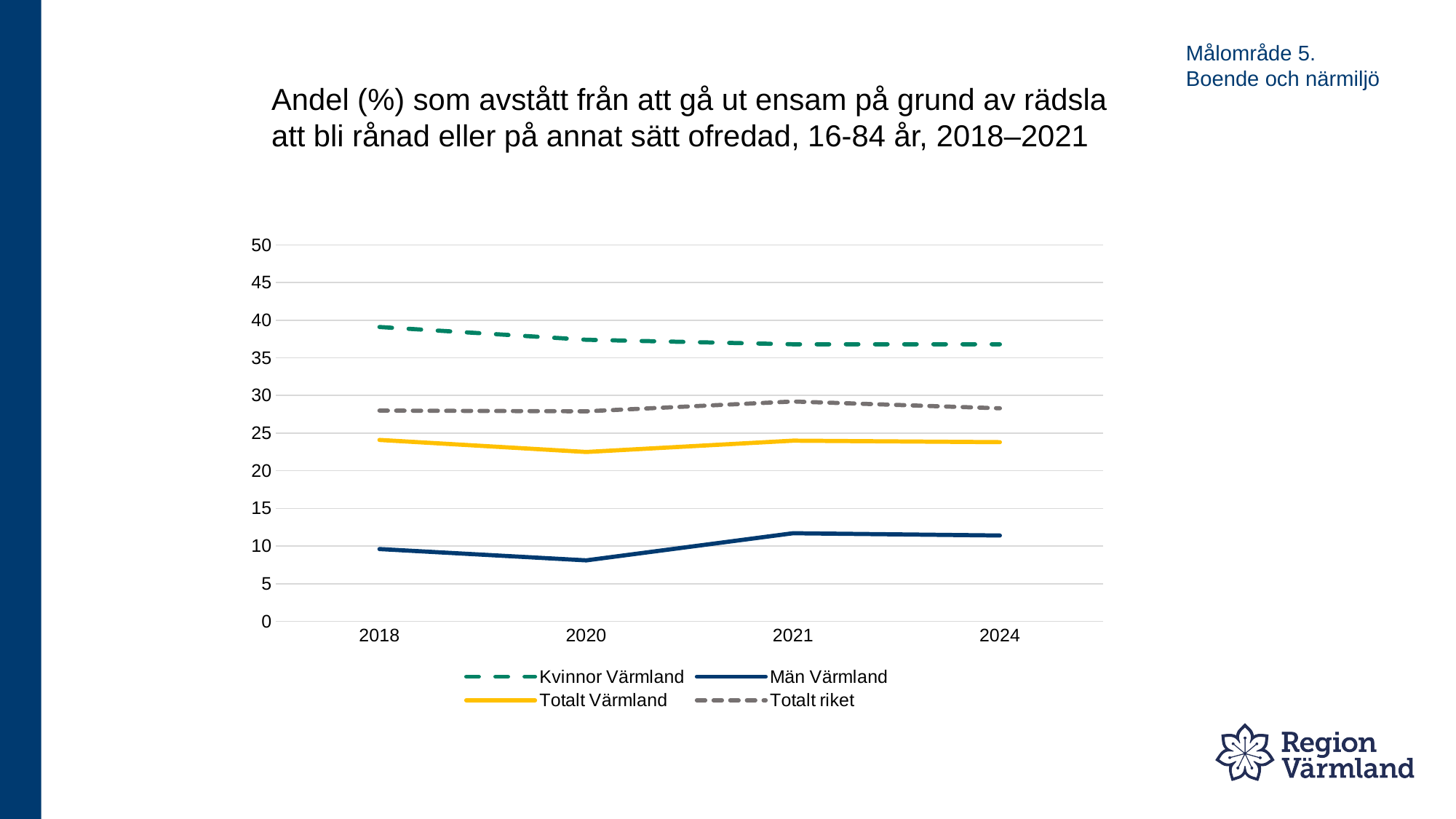
Is the value for Män Värmland in 2020 greater or less than 10? less What kind of chart is shown on the slide? line chart Which series has the lowest values across all years? Män Värmland Is the value for Totalt Värmland in 2020 greater or less than 25? less In 2020, which is larger: Totalt riket or Totalt Värmland? Totalt riket How many series does the legend list? 4 Does the Kvinnor Värmland line rise or fall from 2018 to 2024? fall Which series has the highest values across all years? Kvinnor Värmland Is the value for Totalt riket in 2018 greater or less than 25? greater Which series is drawn with a solid yellow line? Totalt Värmland How many years are shown on the x axis? 4